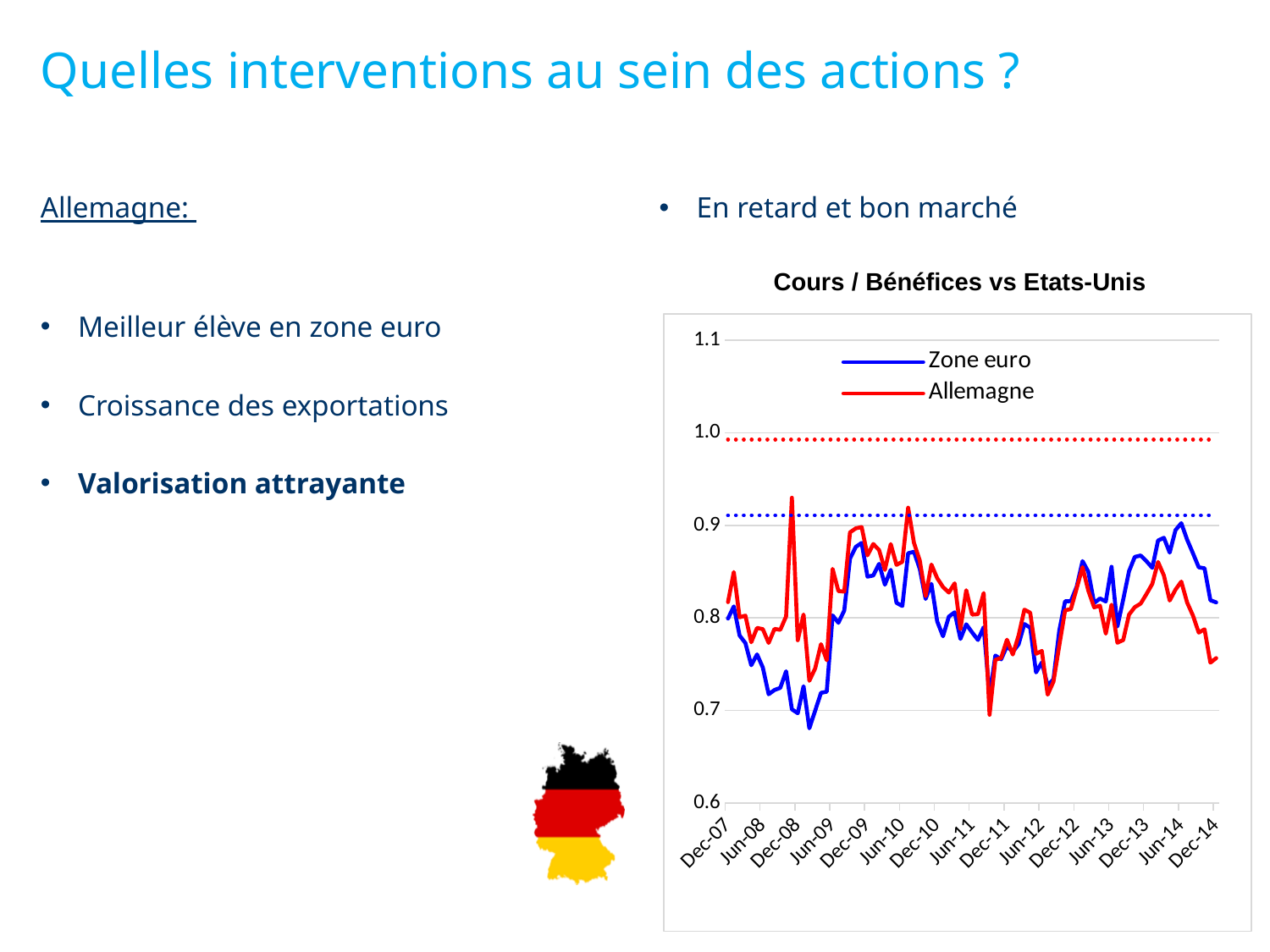
How many date labels are shown on the x axis of the chart? 15 Which colour is used for the Allemagne series in the chart? red Is the lowest value for Zone euro, reached in early 2009, greater or less than 0.7? less What kind of chart is shown under the title "Cours / Bénéfices vs Etats-Unis"? line chart What is the title of the chart on the slide? Cours / Bénéfices vs Etats-Unis Do the values for Allemagne rise or fall between Jun-14 and Dec-14? fall How many series does the legend of the chart list? 2 Is the value for Zone euro at Dec-14 greater or less than 0.8? greater At Dec-14, which series has the higher value, Zone euro or Allemagne? Zone euro Is the value for Allemagne at Dec-14 greater or less than 0.8? less